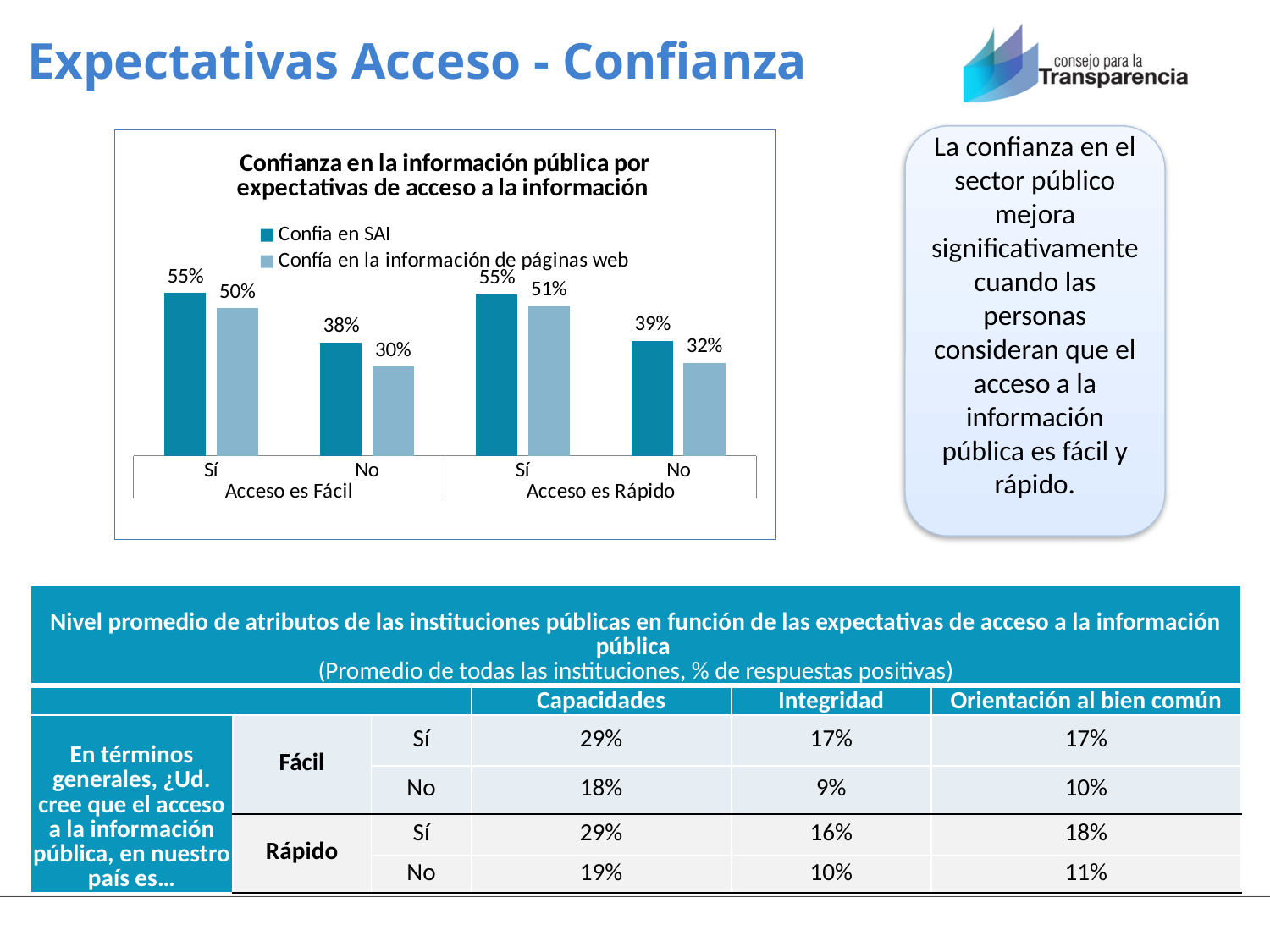
Which is larger: 'Confia en SAI' for 'Sí' under 'Acceso es Rápido' or 'Confía en la información de páginas web' for 'Sí' under 'Acceso es Rápido'? Confia en SAI What type of chart is shown on the slide? bar chart Which category has the lowest value for 'Confía en la información de páginas web'? No (Acceso es Fácil) What is the value of 'Confía en la información de páginas web' for 'Sí' under 'Acceso es Rápido'? 51% What is the difference between 'Confia en SAI' and 'Confía en la información de páginas web' for 'No' under 'Acceso es Rápido'? 7% What is the difference between 'Confia en SAI' for 'Sí' and 'No' under 'Acceso es Fácil'? 17% What is the value of 'Confia en SAI' for 'Sí' under 'Acceso es Fácil'? 55% How many category groups (Sí/No pairs) are shown on the x axis of the chart? 2 What is the value of 'Confia en SAI' for 'No' under 'Acceso es Rápido'? 39% What is the value of 'Confía en la información de páginas web' for 'No' under 'Acceso es Fácil'? 30% What is the title of the chart? Confianza en la información pública por expectativas de acceso a la información How many series does the chart legend list? 2